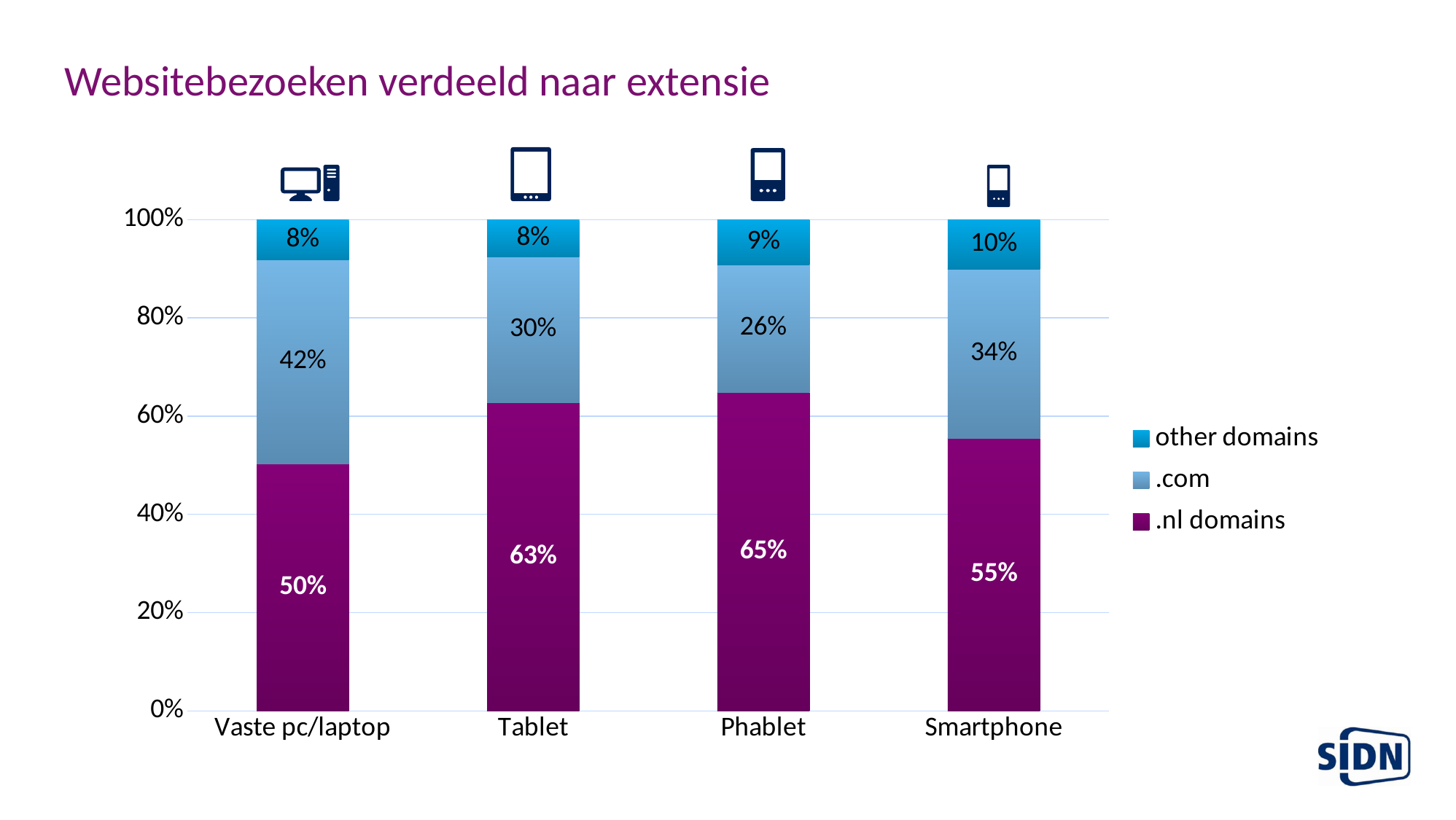
What is the title of the chart? Websitebezoeken verdeeld naar extensie How many series does the legend list? 3 What kind of chart is shown on the slide? Stacked bar chart Which is larger: the .nl domains share for Smartphone or for Tablet? Tablet What is the difference between the .com share for Vaste pc/laptop and for Tablet? 12% Which device has the highest .nl domains share? Phablet What is the .nl domains share for Tablet? 63% What is the .com share for Phablet? 26% Which device has the lowest .nl domains share? Vaste pc/laptop How many device categories are shown on the x axis? 4 What is the .com share for Vaste pc/laptop? 42% What is the other domains share for Smartphone? 10%